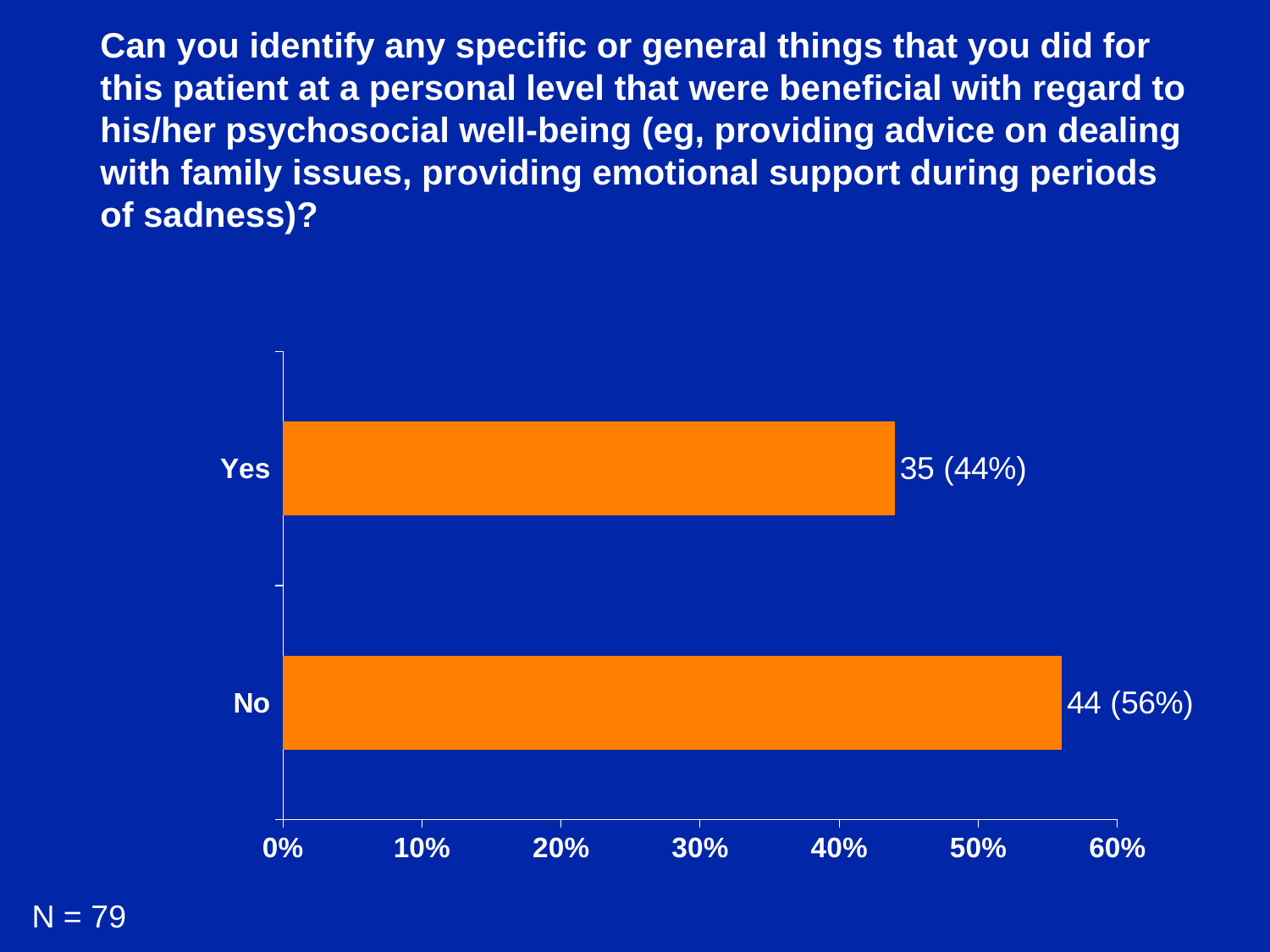
How many more respondents answered "No" than "Yes"? 9 What is the data label shown for the "No" bar? 44 (56%) Which category has the lowest value? Yes What kind of chart is shown on the slide? bar chart What is the difference in percentage points between the "No" and "Yes" responses? 12% How many categories are shown in the chart? 2 Which is larger, the value for "Yes" or the value for "No"? No How many respondents answered "Yes"? 35 Is the value for "Yes" greater or less than 50%? less What percentage of respondents answered "No"? 56% What is the data label shown for the "Yes" bar? 35 (44%) Which category has the highest value? No